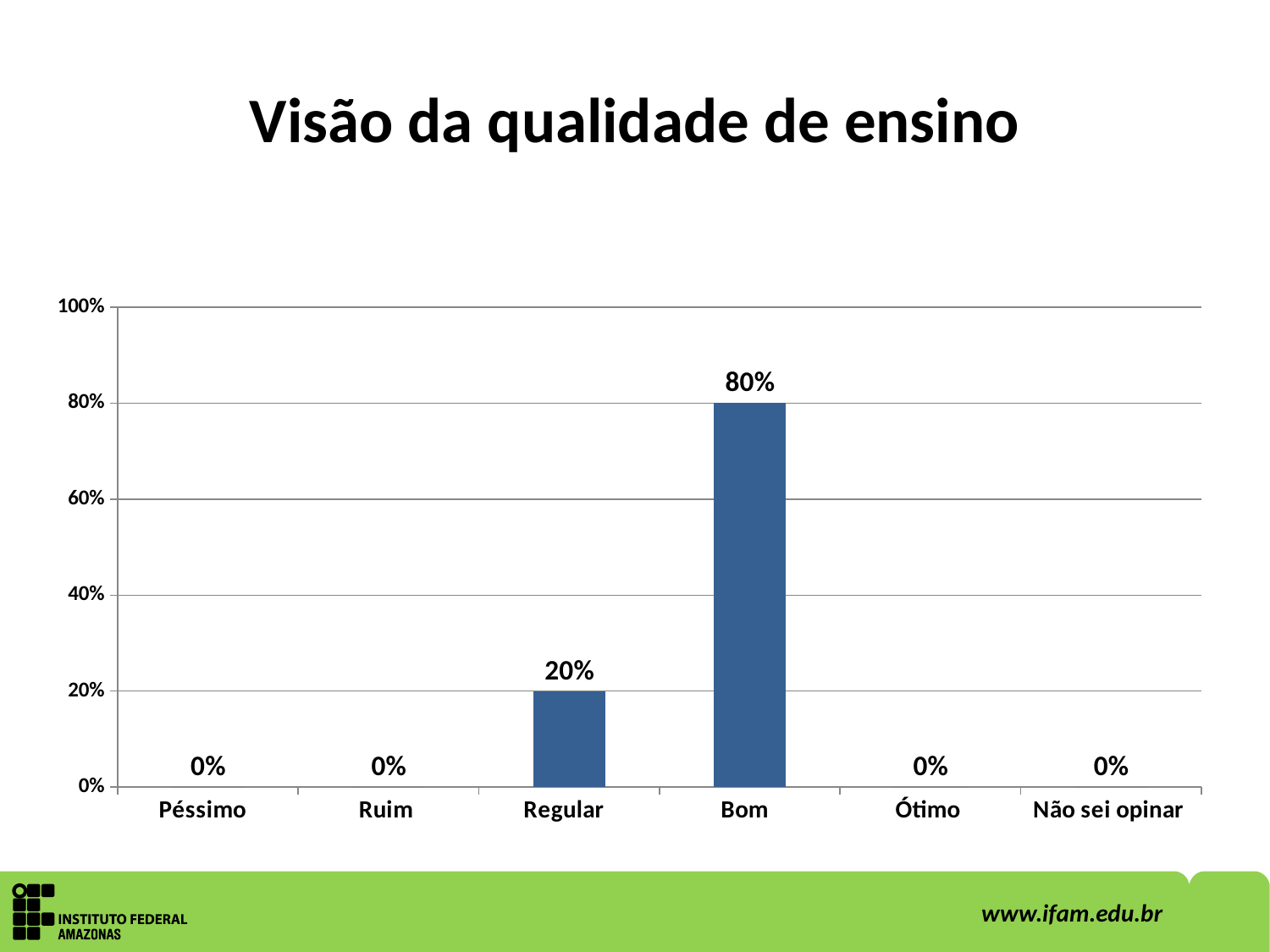
What is the difference between the values for Bom and Regular? 60% Is the value for Bom greater or less than 60%? greater Which category has the highest value? Bom What is the value for Regular? 20% What is the title of the slide? Visão da qualidade de ensino Which is larger, the value for Regular or the value for Bom? Bom What is the value for Ótimo? 0% What is the value for Não sei opinar? 0% How many categories are shown on the x axis? 6 What kind of chart is shown on the slide? bar chart What is the value for Bom? 80% How many categories have a value of 0%? 4